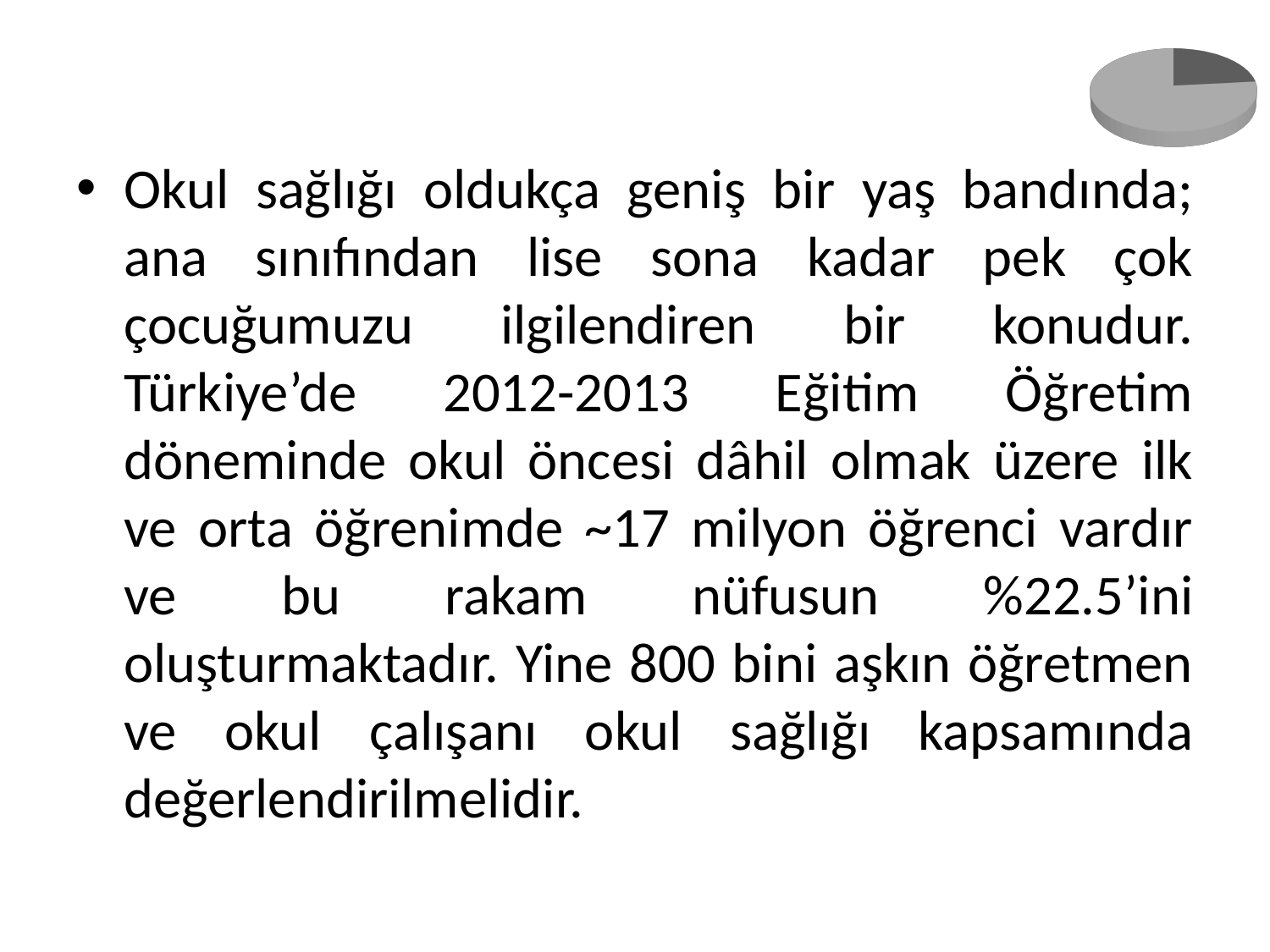
Is the pie chart in the top right corner drawn in 3D? Yes In the pie chart in the top right corner, which slice is the smallest? the dark grey slice In the pie chart in the top right corner, which slice is larger, the dark grey slice or the light grey slice? the light grey slice What kind of chart is shown in the top right corner of the slide? pie chart Does the pie chart in the top right corner have a legend? No How many slices does the pie chart in the top right corner have? 2